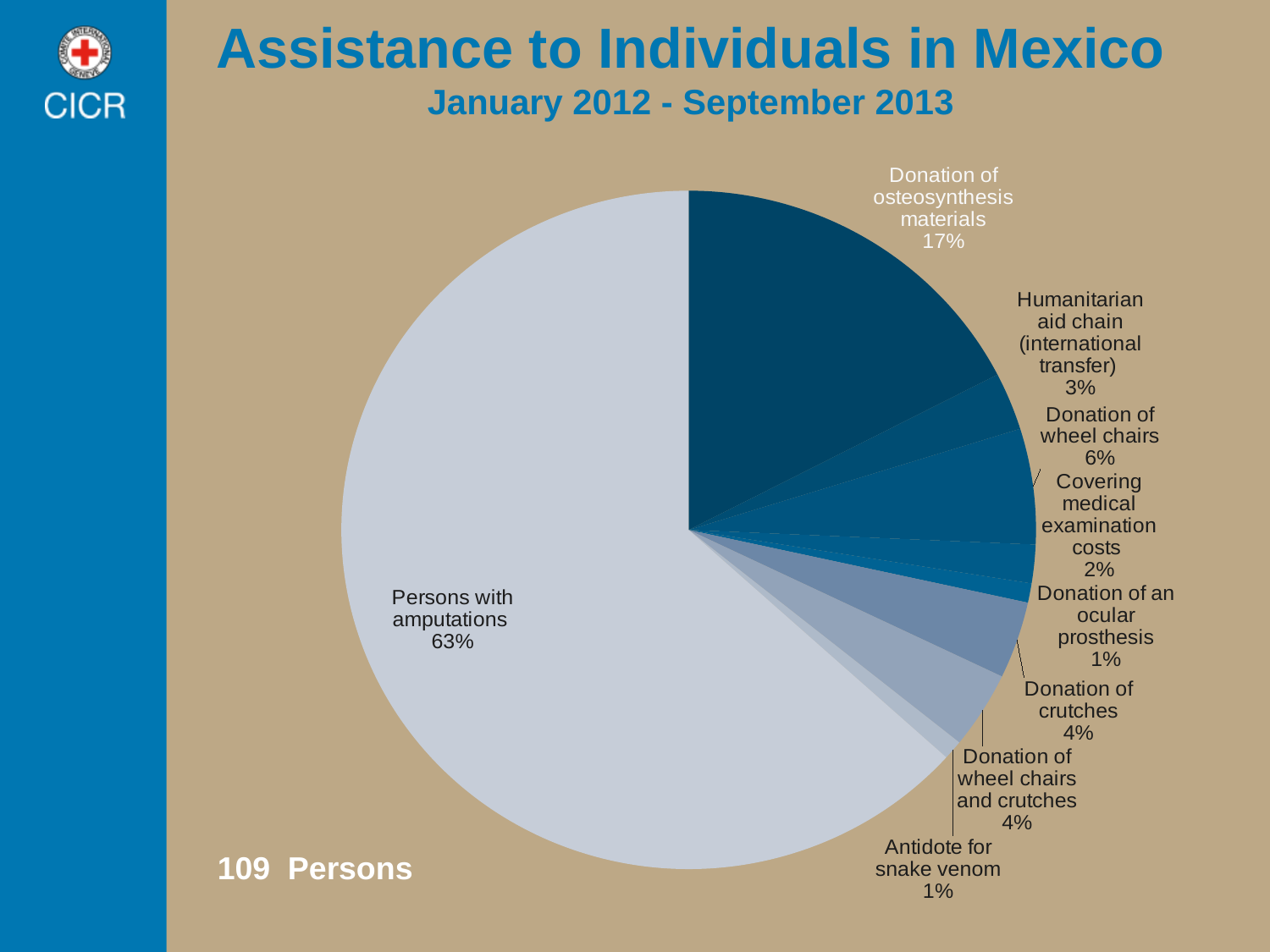
What percentage is shown for "Covering medical examination costs"? 2% What percentage is shown for "Donation of osteosynthesis materials"? 17% What is the title of the chart on the slide? Assistance to Individuals in Mexico What percentage is shown for "Humanitarian aid chain (international transfer)"? 3% What percentage is shown for "Donation of wheel chairs"? 6% Which is larger, the share for "Donation of wheel chairs" or the share for "Donation of crutches"? Donation of wheel chairs How many persons in total does the slide say the chart covers? 109 Persons Which category has the largest slice of the pie? Persons with amputations What is the difference in percentage points between "Persons with amputations" and "Donation of osteosynthesis materials"? 46 What kind of chart is shown on the slide? Pie chart How many categories (slices) does the pie chart have? 9 What share of the pie is labelled "Persons with amputations"? 63%